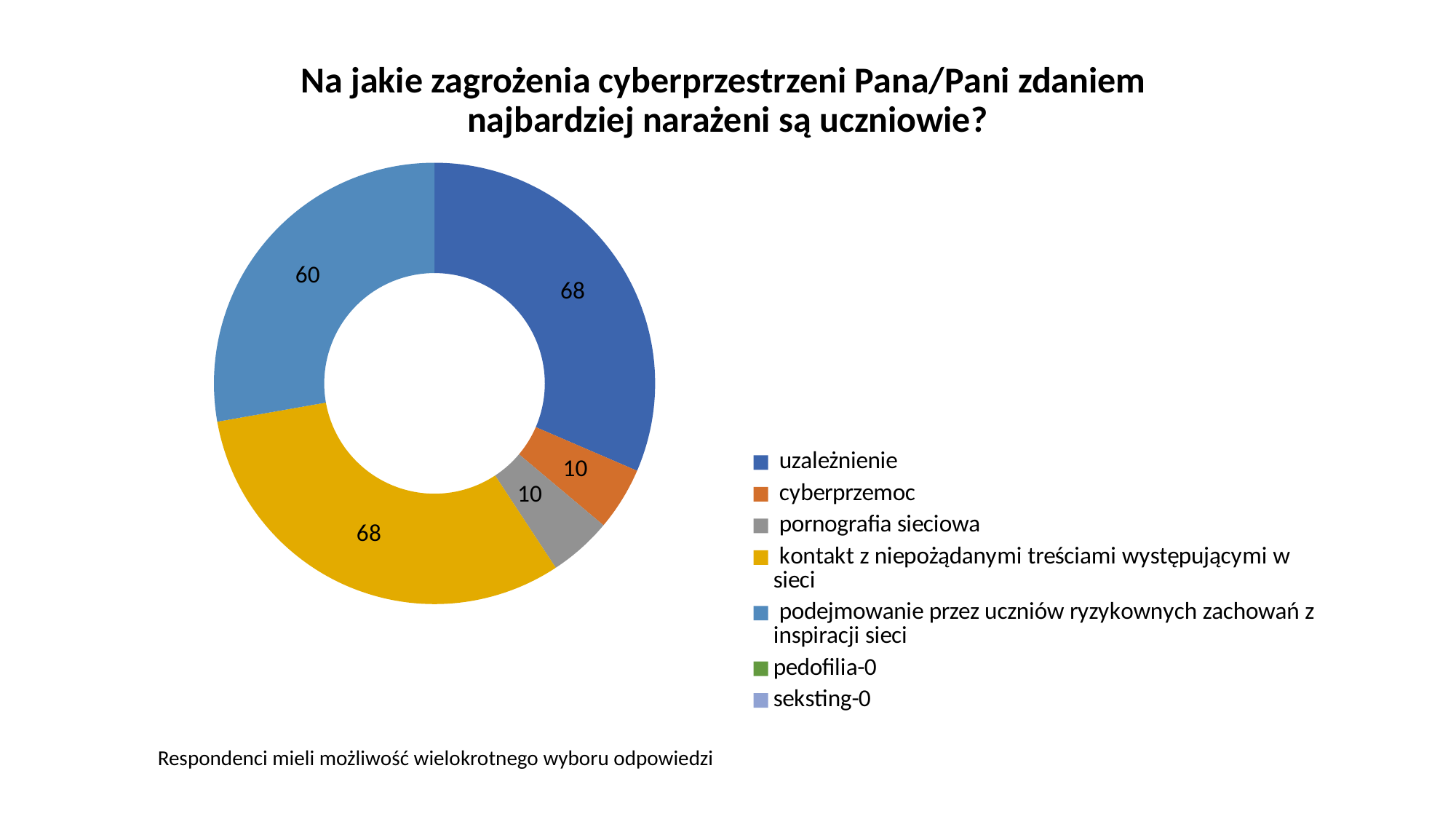
How many categories does the legend list? 7 Which is larger, the value for uzależnienie or the value for podejmowanie przez uczniów ryzykownych zachowań z inspiracji sieci? uzależnienie What is the value for pornografia sieciowa? 10 What kind of chart is shown on the slide? doughnut chart Which two categories in the legend have a value of 0? pedofilia and seksting Which is larger, the value for cyberprzemoc or the value for podejmowanie przez uczniów ryzykownych zachowań z inspiracji sieci? podejmowanie przez uczniów ryzykownych zachowań z inspiracji sieci What is the value for cyberprzemoc? 10 What is the difference between the value for kontakt z niepożądanymi treściami występującymi w sieci and the value for cyberprzemoc? 58 What is the difference between the value for uzależnienie and the value for podejmowanie przez uczniów ryzykownych zachowań z inspiracji sieci? 8 What is the value for podejmowanie przez uczniów ryzykownych zachowań z inspiracji sieci? 60 What is the value for kontakt z niepożądanymi treściami występującymi w sieci? 68 What is the value for uzależnienie? 68